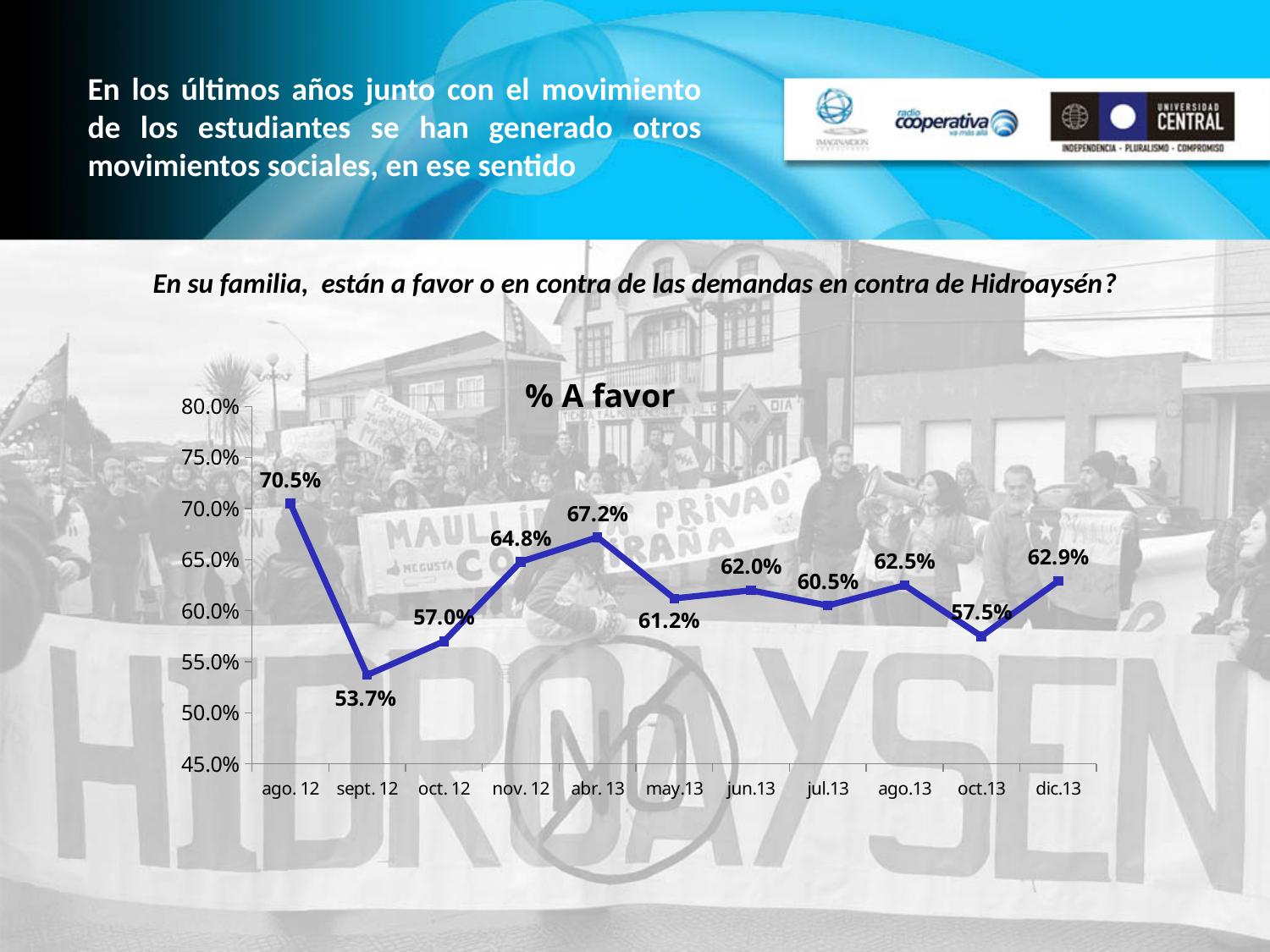
What is the value for abr. 13? 67.2% How many data points are plotted on the line? 11 What is the title of the chart? % A favor What is the value for ago. 12? 70.5% What is the value for sept. 12? 53.7% Does the value rise or fall from ago. 12 to sept. 12? fall Which period has the lowest value? sept. 12 Which is larger, the value for nov. 12 or the value for oct.13? nov. 12 What type of chart is shown on the slide? line chart What is the difference between the values for ago. 12 and sept. 12? 16.8% Which period has the highest value? ago. 12 What is the value for dic.13? 62.9%